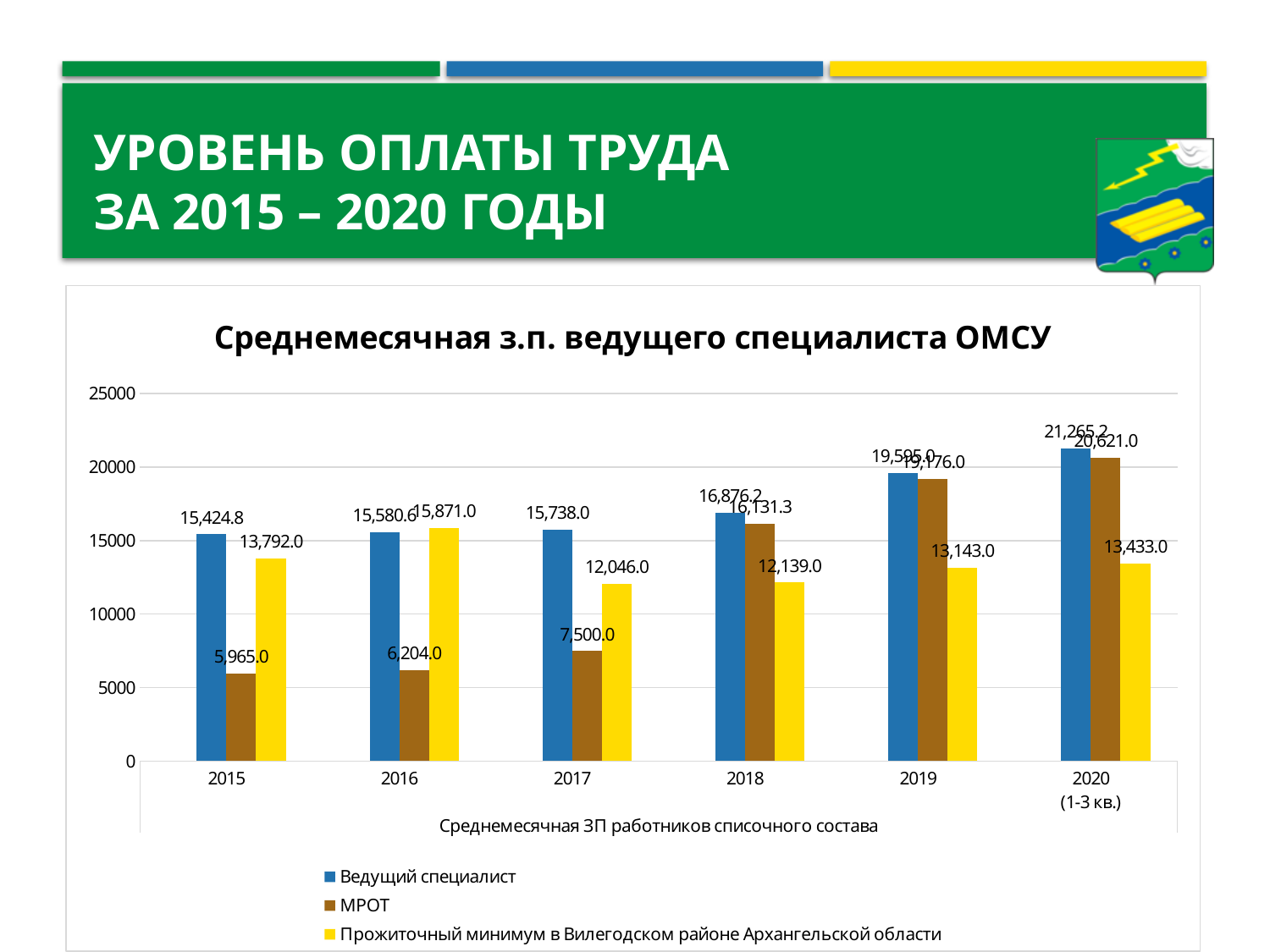
What is the difference between Ведущий специалист and МРОТ in 2017? 8,238.0 Is the value for МРОТ in 2017 greater or less than 10000? less How many series does the legend list? 3 What kind of chart is shown on the slide? bar chart What is the value for МРОТ in 2015? 5,965.0 What is the value for Ведущий специалист in 2017? 15,738.0 Do the values for Ведущий специалист rise or fall from 2015 to 2020? rise In which year is the value for Ведущий специалист the highest? 2020 (1-3 кв.) How many years are shown on the x axis? 6 What is the value for Прожиточный минимум в Вилегодском районе Архангельской области in 2020 (1-3 кв.)? 13,433.0 In 2016, which is larger: Ведущий специалист or Прожиточный минимум в Вилегодском районе Архангельской области? Прожиточный минимум в Вилегодском районе Архангельской области In which year is the value for МРОТ the lowest? 2015